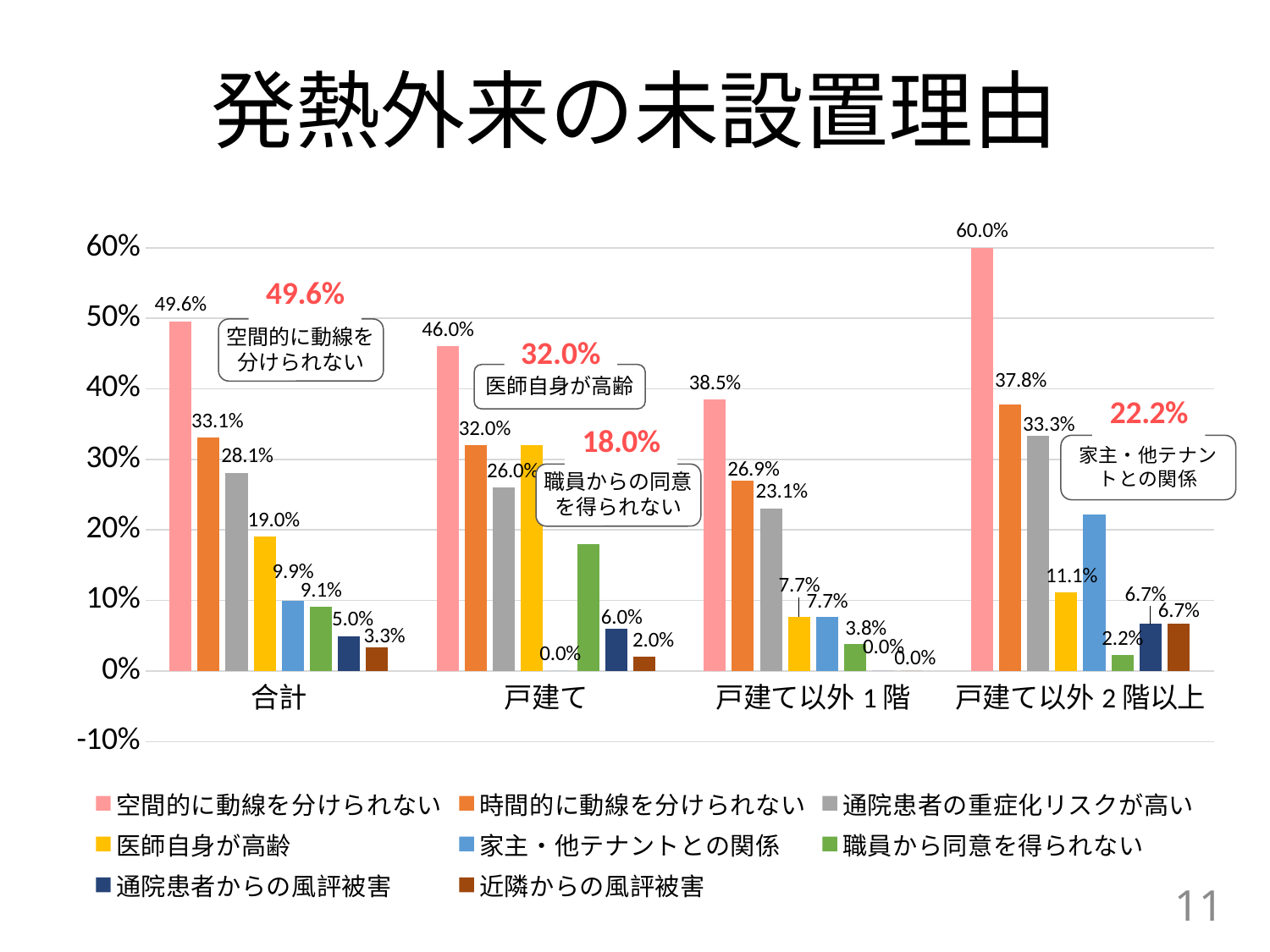
How many series does the legend list? 8 What is the difference between 空間的に動線を分けられない and 時間的に動線を分けられない for 戸建て以外２階以上? 22.2% Which is larger for 戸建て: 通院患者の重症化リスクが高い or 職員から同意を得られない? 通院患者の重症化リスクが高い What is the title of the chart? 発熱外来の未設置理由 What is the value of 家主・他テナントとの関係 for 戸建て以外２階以上? 22.2% What type of chart is shown on the slide? bar chart How many categories are shown on the x axis? 4 Which series has the lowest value for 合計? 近隣からの風評被害 What is the value of 空間的に動線を分けられない for 合計? 49.6% What is the value of 医師自身が高齢 for 戸建て? 32.0% Which category has the highest value for 空間的に動線を分けられない? 戸建て以外２階以上 What is the value of 職員から同意を得られない for 戸建て以外１階? 3.8%